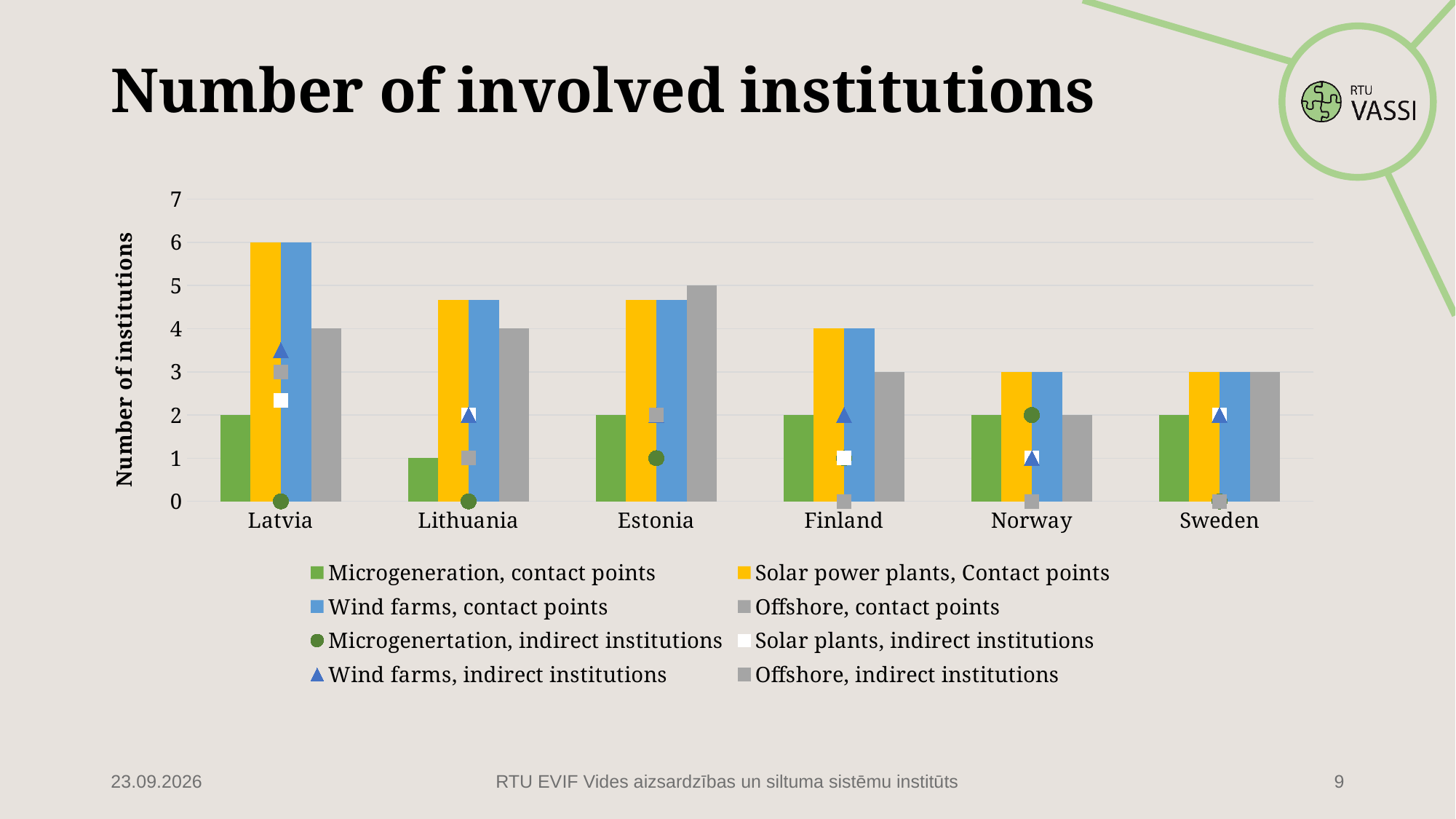
How many countries are shown on the x axis? 6 Which country has the lowest value for Microgeneration, contact points? Lithuania Is the value of Solar power plants, Contact points for Lithuania greater or less than 4? greater How many series does the legend list? 8 Which country has the highest value for Wind farms, contact points? Latvia What is the value of Microgeneration, contact points for Lithuania? 1 What is the difference between Solar power plants, Contact points and Microgeneration, contact points for Latvia? 4 What is the value of Offshore, contact points for Estonia? 5 What type of chart is shown on the slide? combination bar and line chart What is the value of Solar power plants, Contact points for Latvia? 6 Which is larger for Norway: Offshore, contact points or Wind farms, contact points? Wind farms, contact points What is the value of Wind farms, contact points for Finland? 4